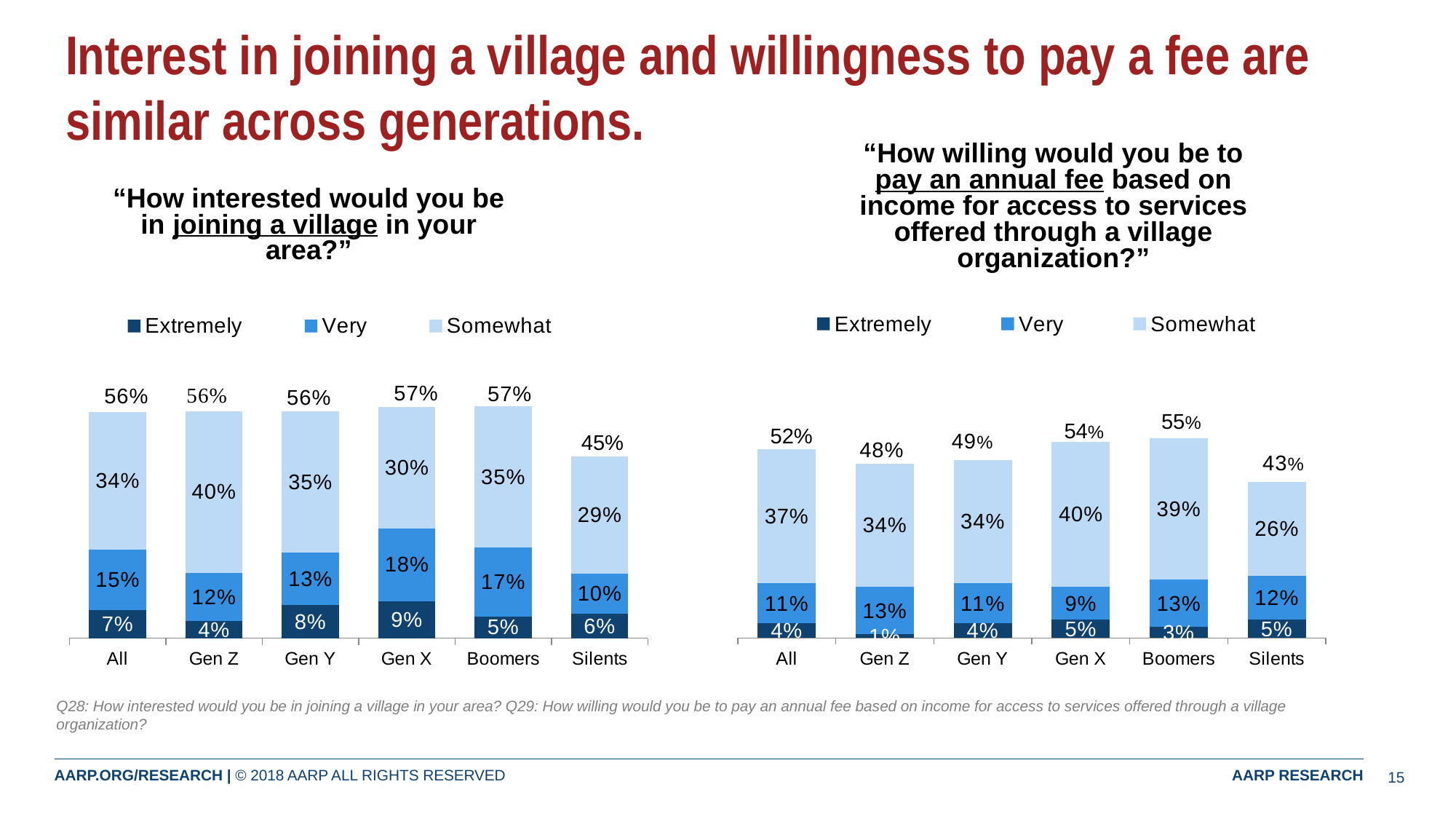
In the left chart (interest in joining a village), what is the difference between the 'Somewhat' values for Gen Z and Gen X? 10% In the left chart (interest in joining a village), what is the total labeled above the Silents bar? 45% In the left chart (interest in joining a village), which is larger: the 'Extremely' value for Gen Y or for Boomers? Gen Y In the right chart (willingness to pay an annual fee), what is the difference between the totals for Gen X and Silents? 11% In the right chart (willingness to pay an annual fee), which generation has the highest total? Boomers How many series does the legend of the left chart list? 3 In the left chart (interest in joining a village), what percentage of Gen X respondents are 'Very' interested? 18% How many generation categories are shown on the x axis of the right chart? 6 In the right chart (willingness to pay an annual fee), what percentage of Boomers are 'Somewhat' willing? 39% In the right chart (willingness to pay an annual fee), what is the 'Extremely' value for Gen Z? 1% What type of chart is used on the left side of the slide? Stacked bar chart In the left chart (interest in joining a village), which generation has the lowest total? Silents